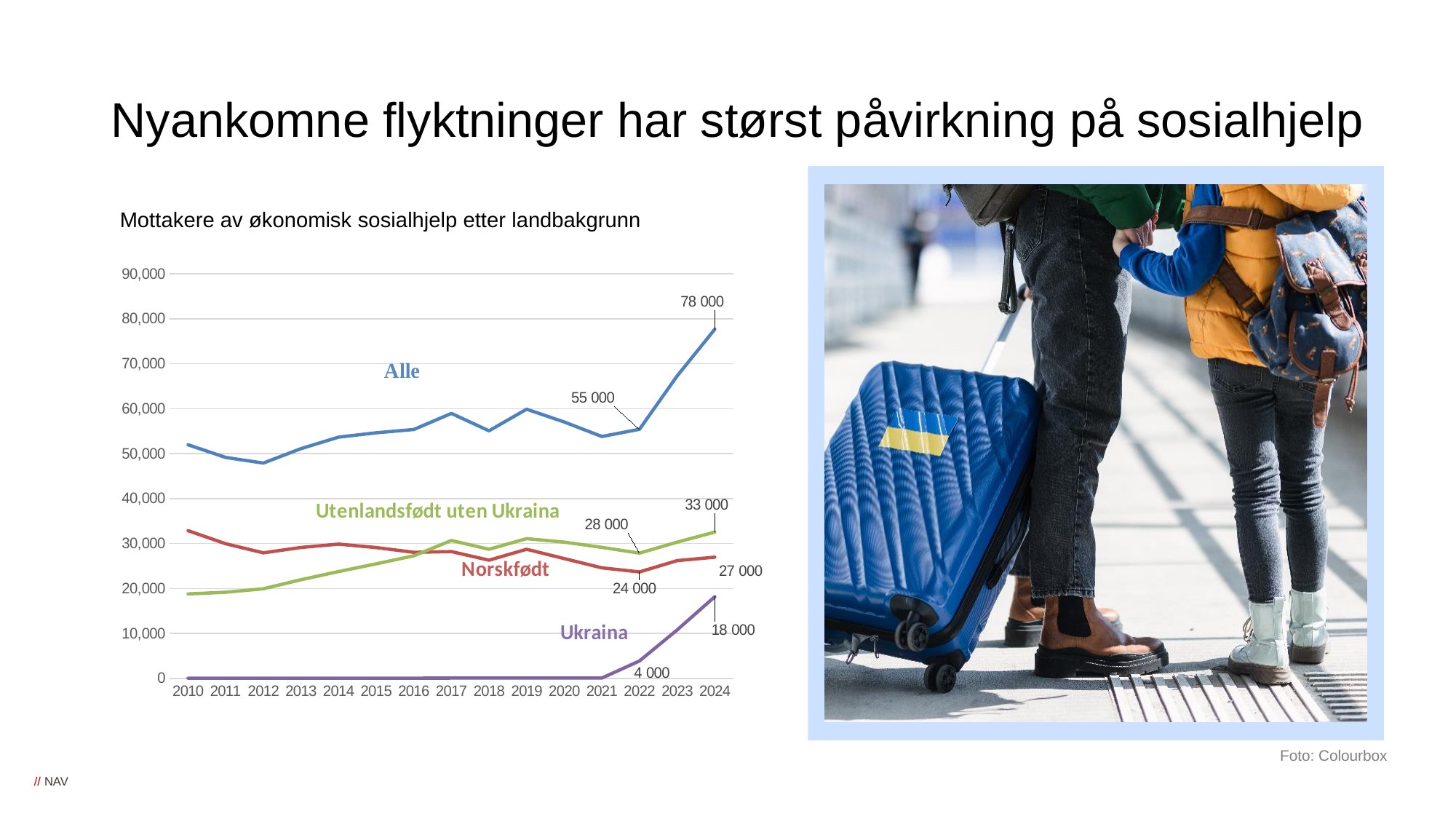
Which series has the highest value in 2024? Alle What is the difference between Utenlandsfødt uten Ukraina and Norskfødt in 2024? 6 000 How many series are plotted in the chart? 4 Which series has the lowest value in 2010? Ukraina What is the value for Norskfødt in 2024? 27 000 In 2024, which is larger: Utenlandsfødt uten Ukraina or Norskfødt? Utenlandsfødt uten Ukraina What is the value for Utenlandsfødt uten Ukraina in 2022? 28 000 What is the value for Alle in 2024? 78 000 What is the difference between the Alle values in 2024 and 2022? 23 000 What kind of chart is shown on the slide? Line chart Is the value for Alle in 2012 greater or less than 50,000? less What is the value for Ukraina in 2022? 4 000